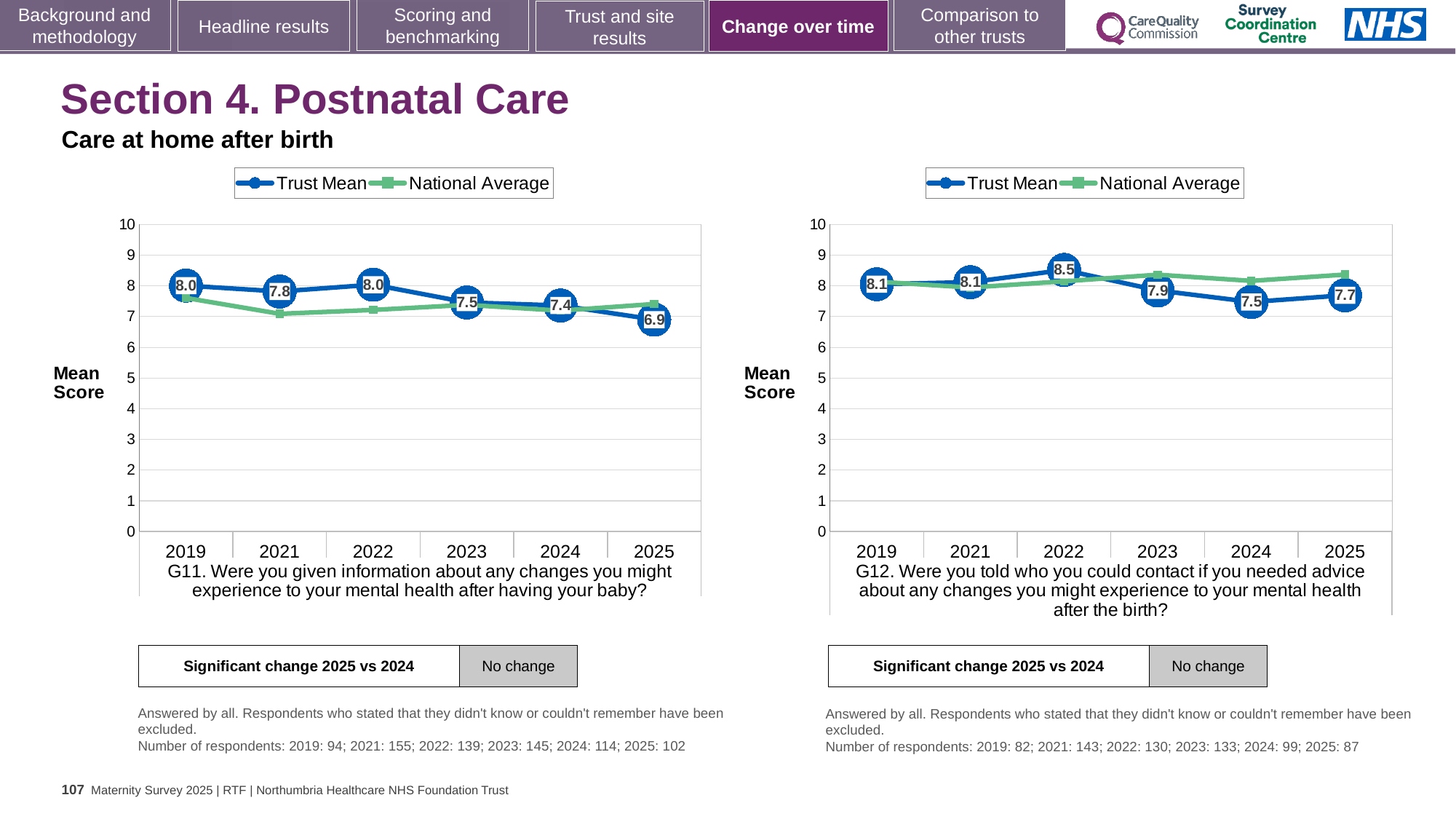
In the G11 chart (left), what is the difference between the Trust Mean scores for 2019 and 2025? 1.1 In the G11 chart (left), what is the Trust Mean score for 2021? 7.8 In the G11 chart (left), which year has the lowest Trust Mean score? 2025 In the G11 chart (left), is the National Average for 2021 greater or less than 8? less In the G12 chart (right), which year has the highest Trust Mean score? 2022 In the G12 chart (right), what is the Trust Mean score for 2024? 7.5 In the G12 chart (right), is the Trust Mean score for 2025 higher or lower than for 2024? higher How many years are plotted on the x axis of the G11 chart (left)? 6 What type of chart is the G12 chart (right)? line chart In the G11 chart (left), what is the Trust Mean score for 2025? 6.9 In the G12 chart (right), what is the difference between the Trust Mean scores for 2022 and 2024? 1.0 In the G12 chart (right), what is the Trust Mean score for 2022? 8.5